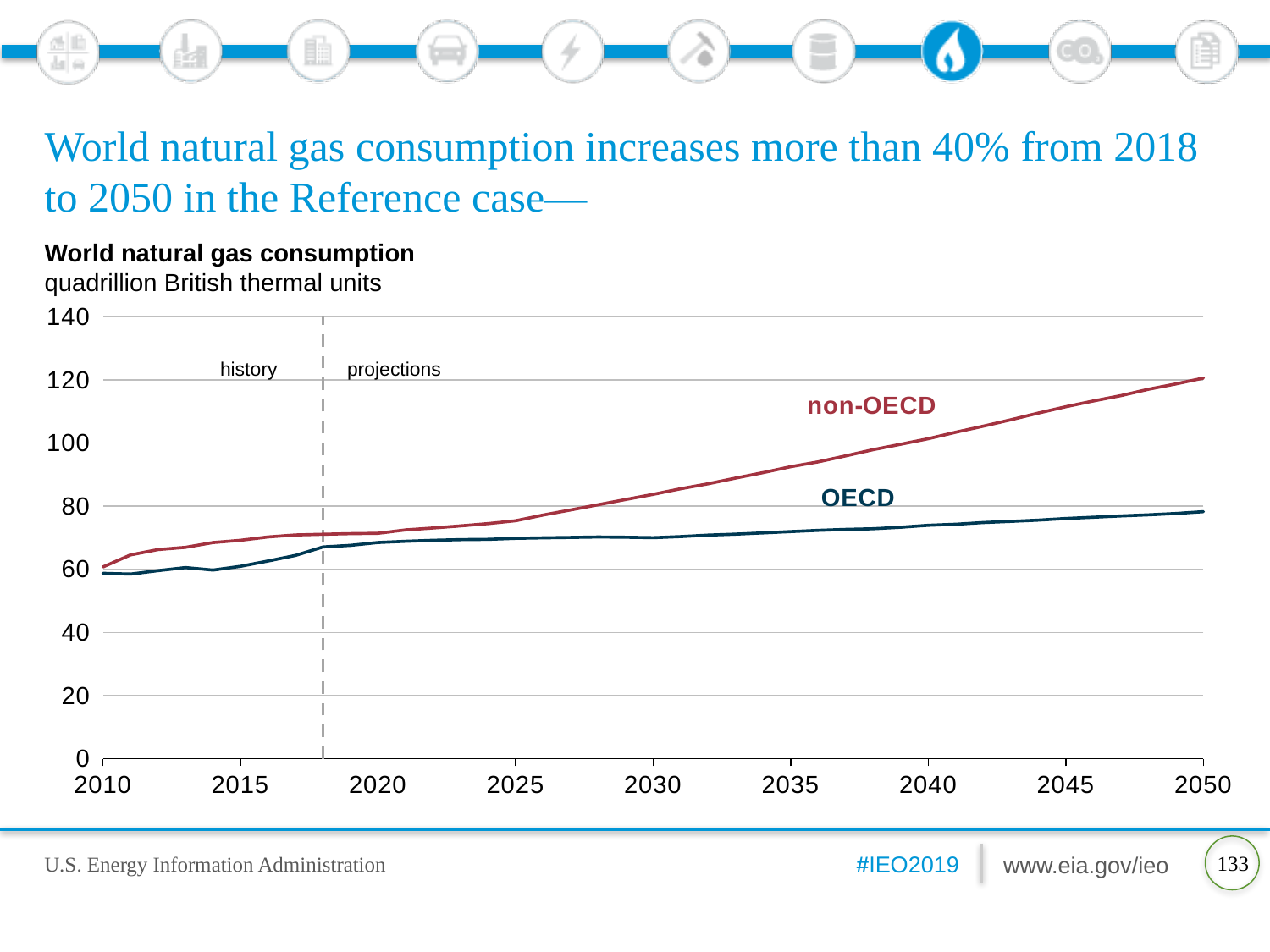
What kind of chart is shown on the slide? line chart Is the OECD value in 2010 greater or less than 80? less Does the non-OECD line rise or fall from 2010 to 2050? rise Is the OECD value in 2050 greater or less than 60? greater Is the non-OECD value in 2035 greater or less than 80? greater How many series are plotted on the chart? 2 What do the labels on either side of the dashed vertical line say? history and projections How many year labels are shown on the x axis? 9 What unit is the chart measured in? quadrillion British thermal units Which series has the higher value in 2050, non-OECD or OECD? non-OECD